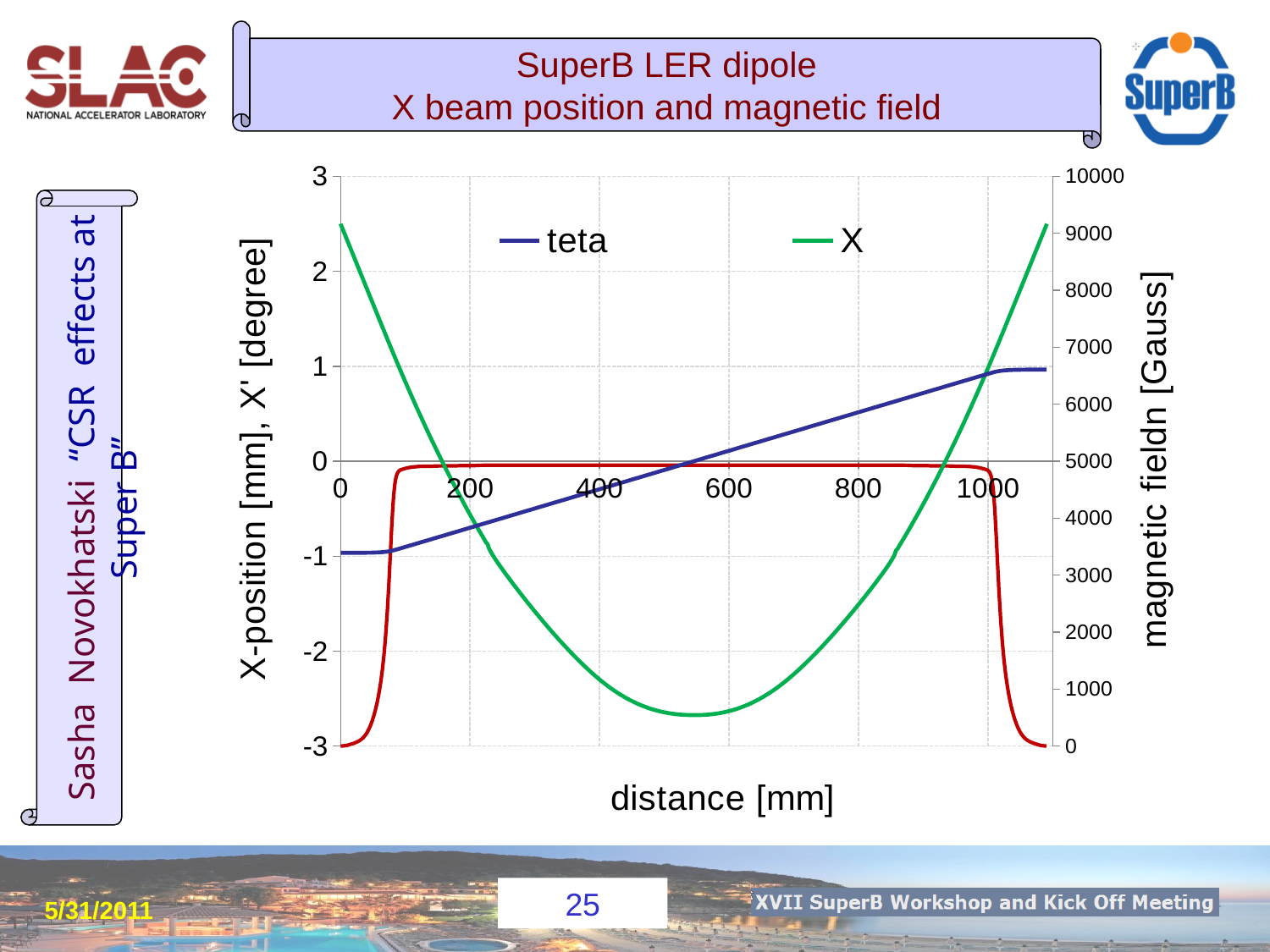
Is the magnetic field (red line) at a distance of 500 mm greater or less than 4000 Gauss? greater Is the value of teta at a distance of 0 mm greater or less than 0? less Which two series are named in the chart legend? teta and X Does the teta series rise or fall as distance increases from 0 to 1000 mm? rise Is the value of teta at a distance of 1000 mm greater or less than 0? greater At a distance of 0 mm, which series has the larger value, teta or X? X At a distance of 600 mm, which series has the larger value, teta or X? teta What is the title of the horizontal axis of the chart? distance [mm] How many series does the chart legend list? 2 What kind of chart is shown on the slide? line chart